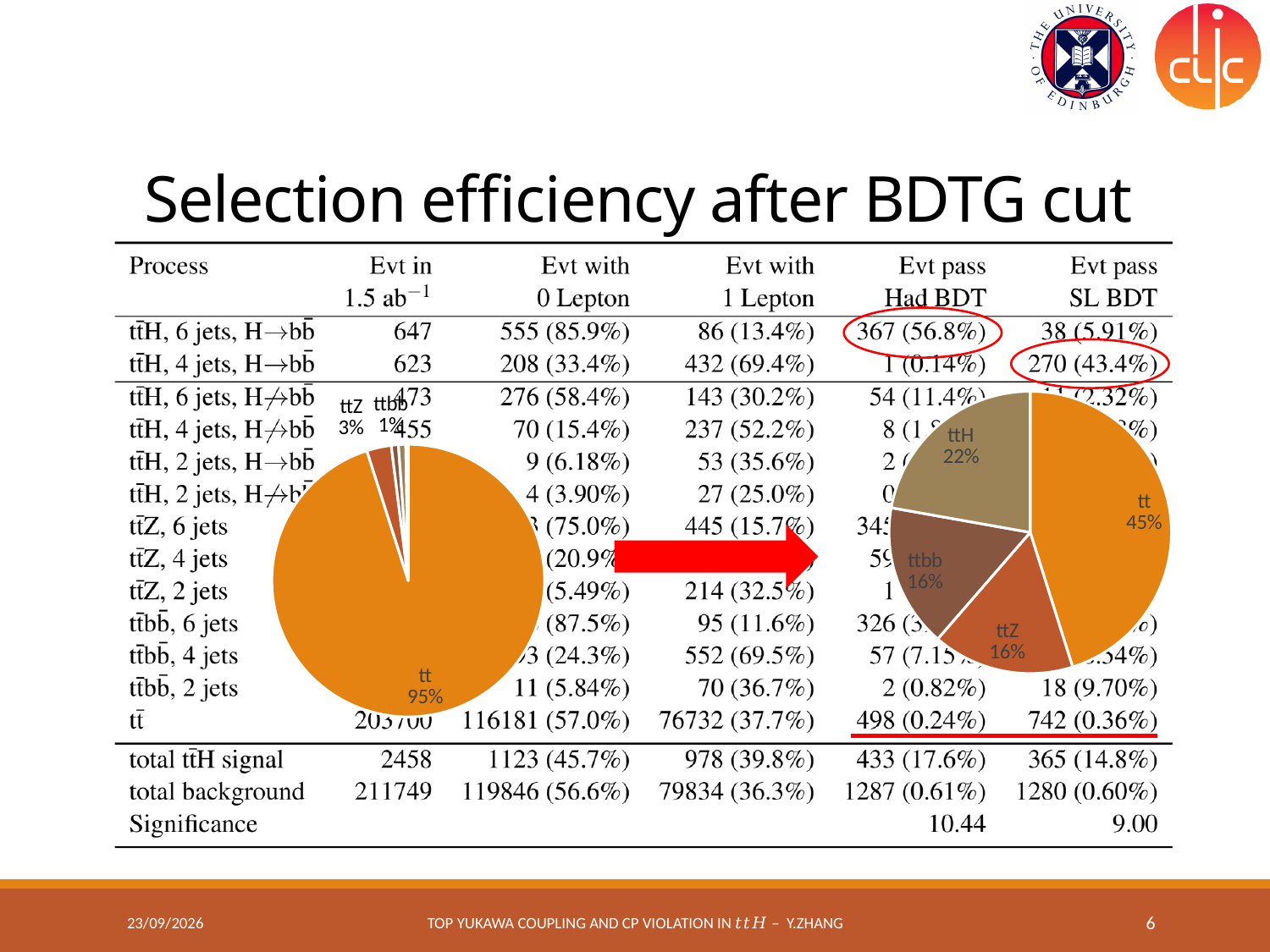
In the left pie chart, what share does tt have? 95% In the left pie chart, which slice is larger, ttZ or ttbb? ttZ In the left pie chart, what share does ttZ have? 3% In the right pie chart, what share does ttH have? 22% In the right pie chart, which category has the largest slice? tt What type of chart is shown on the left side of the slide? pie chart How many labelled slices does the right pie chart have? 4 In the left pie chart, which category has the largest slice? tt In the right pie chart, how many percentage points larger is the tt share than the ttH share? 23